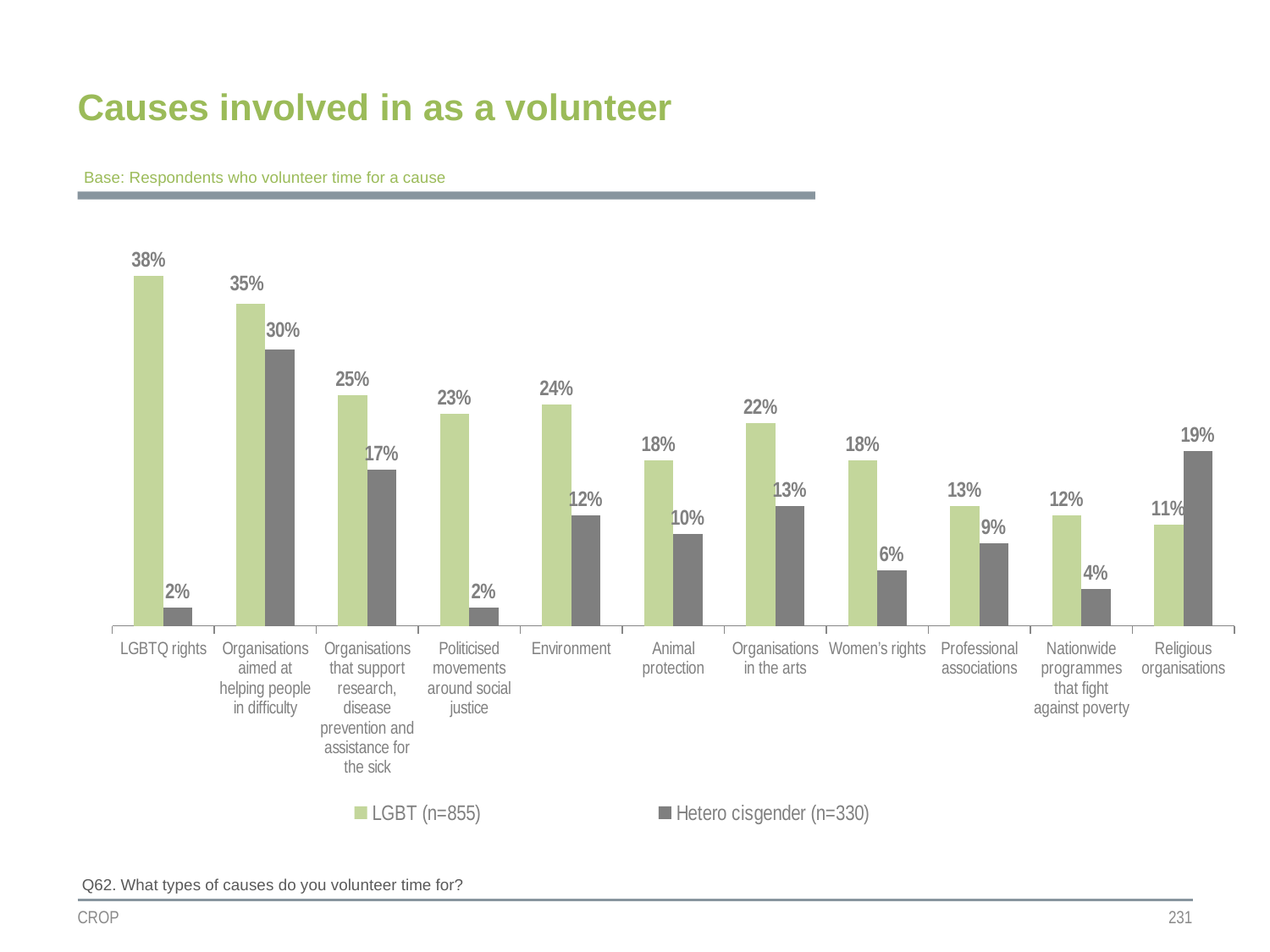
What is the sample size (n) for the LGBT series shown in the legend? 855 What is the Hetero cisgender value for Organisations aimed at helping people in difficulty? 30% Which cause has the lowest LGBT value? Religious organisations What is the difference between the LGBT and Hetero cisgender values for LGBTQ rights? 36% What is the Hetero cisgender value for Religious organisations? 19% What percentage of LGBT respondents volunteer for LGBTQ rights? 38% Which cause has the highest LGBT value? LGBTQ rights How many series does the legend list? 2 What kind of chart is shown on the slide? Bar chart How many causes are shown on the x axis? 11 For Religious organisations, which group has the larger value, LGBT or Hetero cisgender? Hetero cisgender Which cause has the highest Hetero cisgender value? Organisations aimed at helping people in difficulty